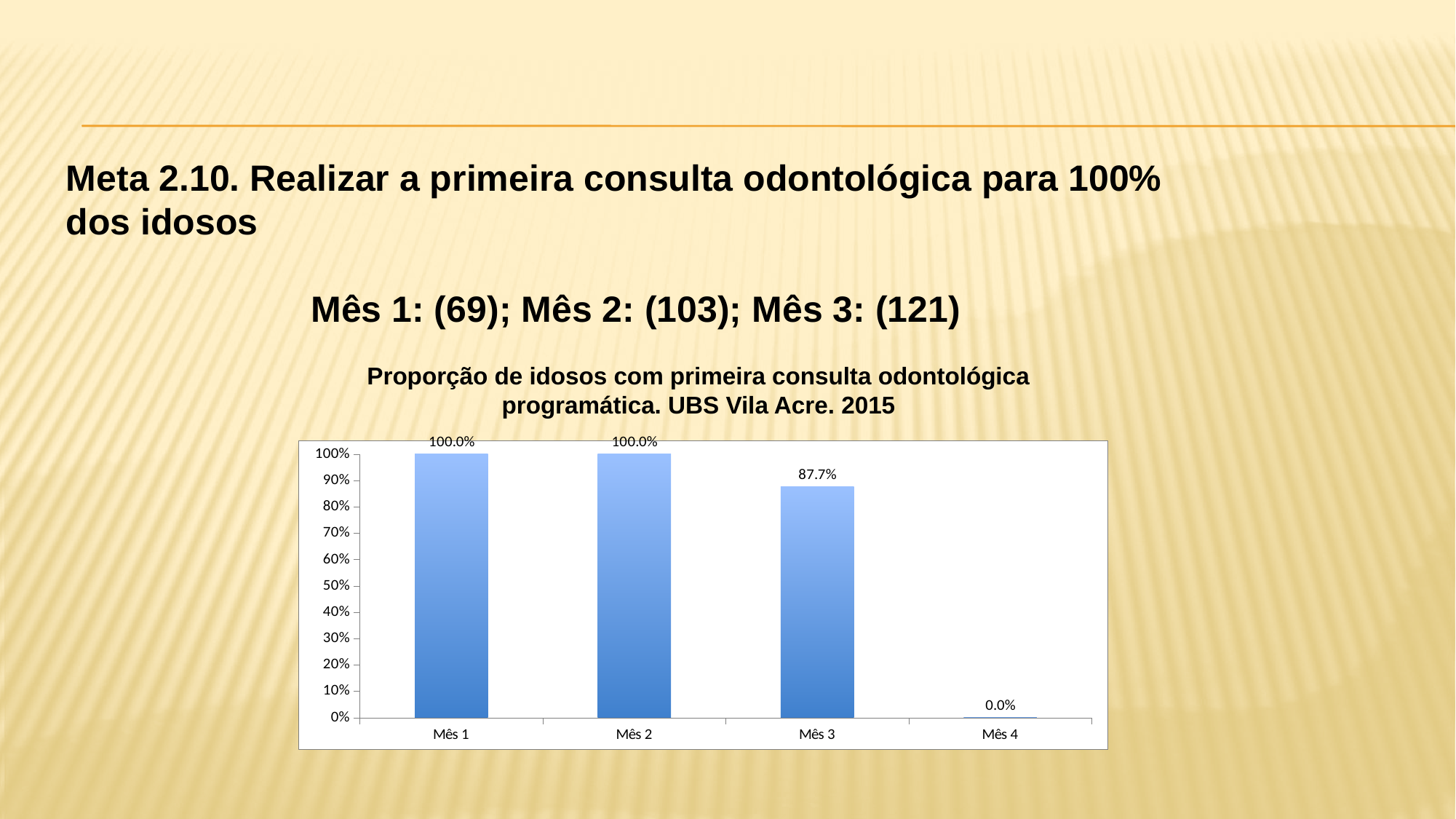
What is the title of the chart? Proporção de idosos com primeira consulta odontológica programática. UBS Vila Acre. 2015 Which is larger, the value for Mês 2 or the value for Mês 3? Mês 2 What kind of chart is shown on the slide? bar chart What is the value for Mês 1? 100.0% Is the value for Mês 3 greater or less than 80%? greater Which category has the lowest value? Mês 4 What is the difference between the values for Mês 2 and Mês 3? 12.3% How many categories are shown on the x axis? 4 What is the value for Mês 4? 0.0% What is the highest value shown on the y axis? 100% Do the values rise or fall from Mês 2 to Mês 4? fall What is the value for Mês 3? 87.7%